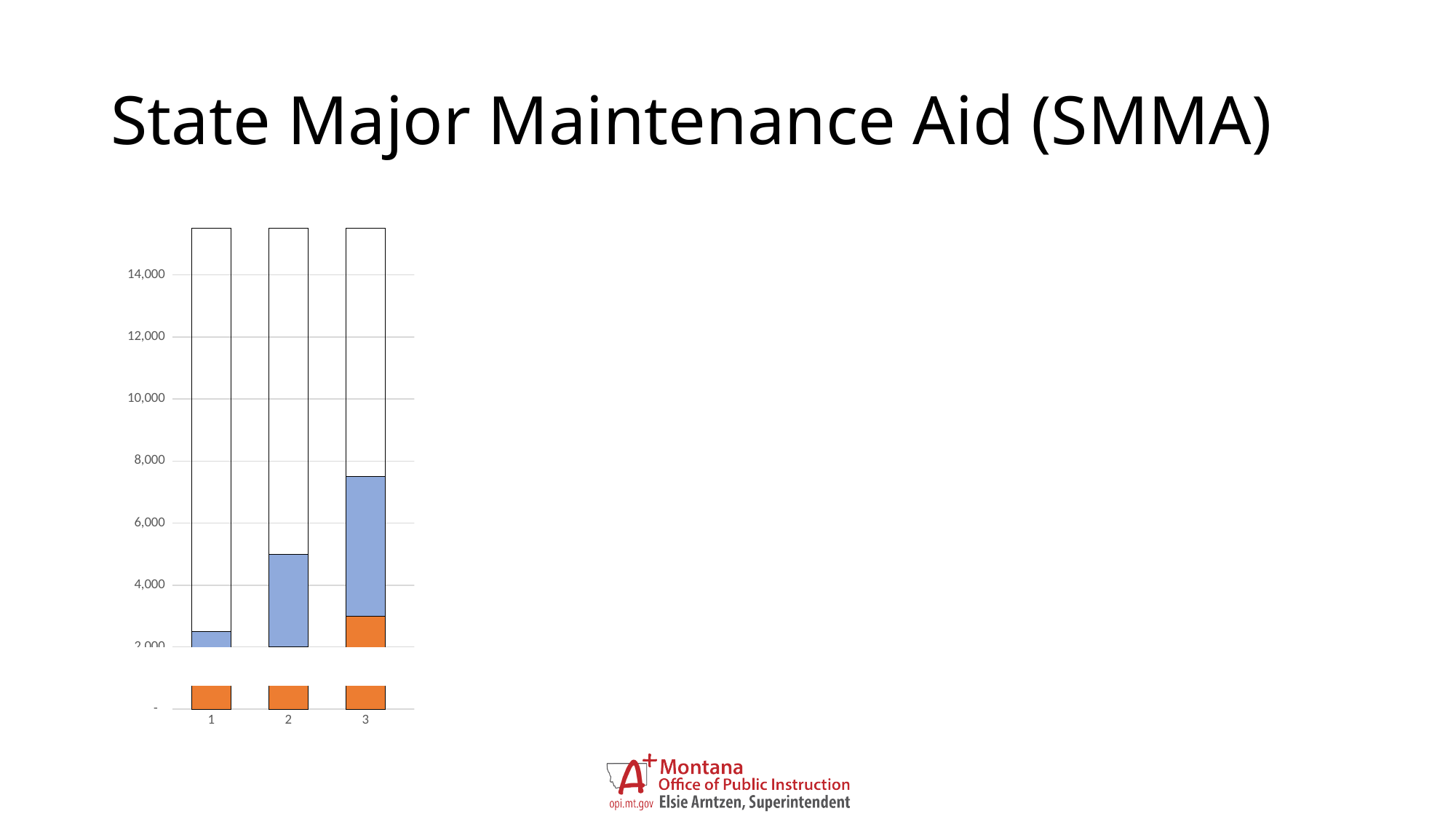
Is the top of the blue segment in bar 2 greater or less than 4,000? greater Does the height of the blue segment rise or fall from bar 1 to bar 3? rise Is the top of the blue segment in bar 3 greater or less than 8,000? less What is the highest labelled tick on the y axis? 14,000 Is the top of the blue segment in bar 2 greater or less than 6,000? less What are the category labels on the x axis? 1, 2, 3 Which bar has the larger blue segment, bar 1 or bar 3? bar 3 How many bars (categories) are plotted on the x axis? 3 What kind of chart is shown on the slide? stacked bar chart Which bar has the tallest blue segment? 3